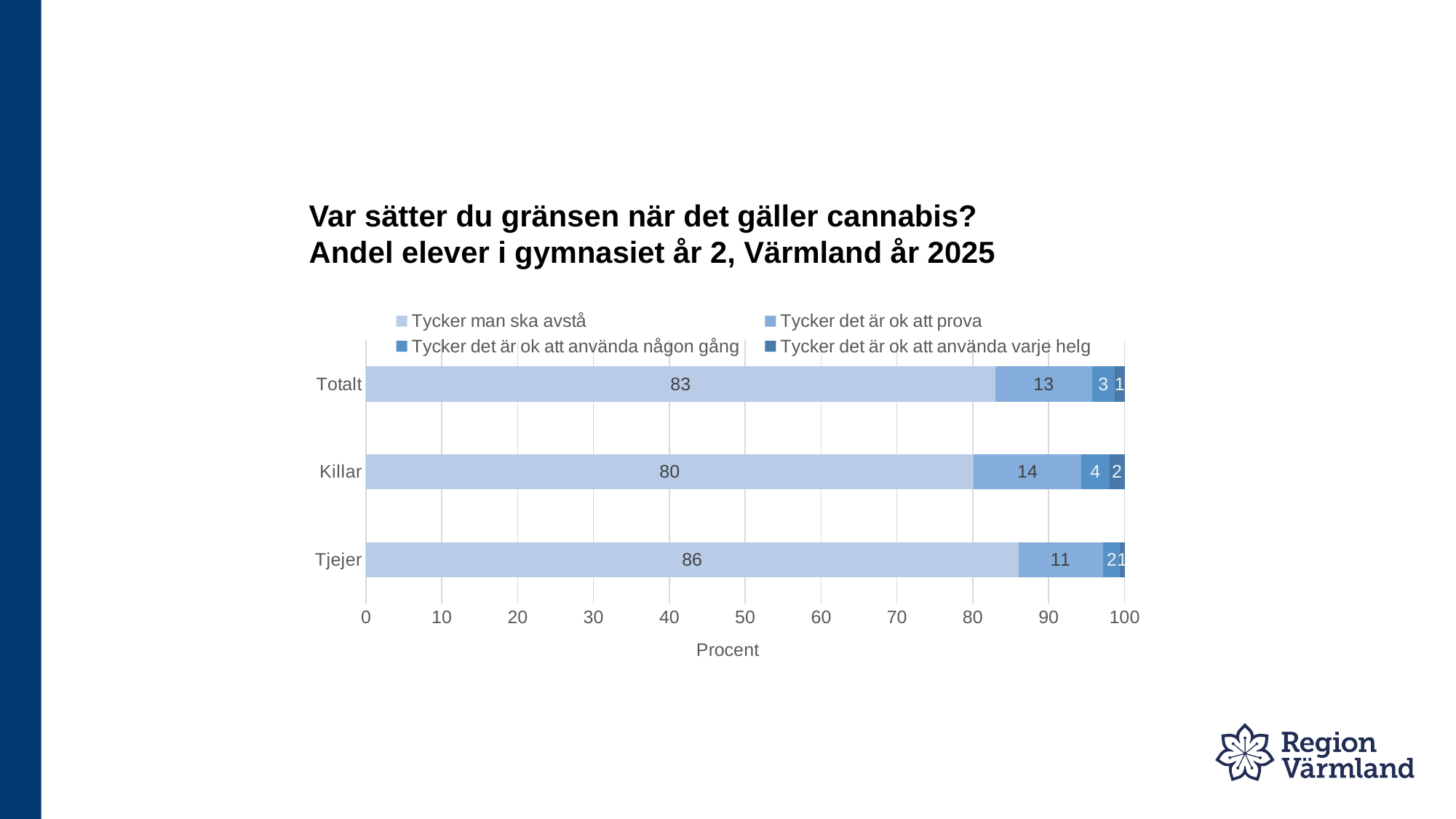
What is the label of the horizontal axis? Procent What is the value for 'Tycker det är ok att prova' for Killar? 14 How many series does the legend list? 4 Which is larger: the 'Tycker det är ok att prova' value for Killar or for Totalt? Killar How many categories are shown on the vertical axis? 3 What is the value for 'Tycker man ska avstå' for Tjejer? 86 Which category has the lowest value for 'Tycker det är ok att prova'? Tjejer What is the value for 'Tycker det är ok att använda varje helg' for Killar? 2 Which category has the highest value for 'Tycker man ska avstå'? Tjejer What is the value for 'Tycker det är ok att använda någon gång' for Totalt? 3 What type of chart is shown on the slide? Stacked bar chart What is the difference between the 'Tycker man ska avstå' values for Tjejer and Killar? 6